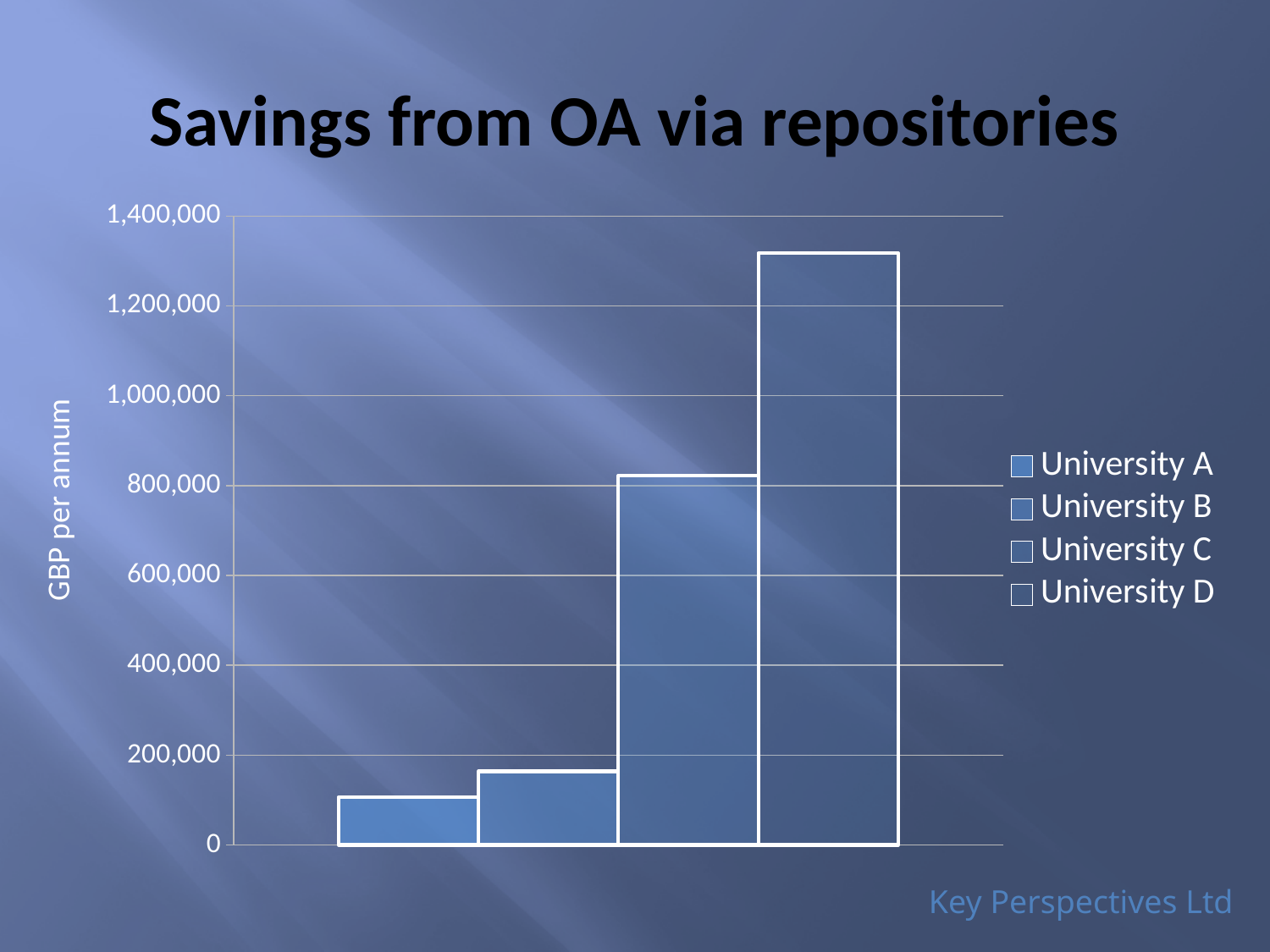
Do the bar values rise or fall from University A to University D? rise How many bars are plotted in the chart? 4 Is the value for University A greater or less than 200,000? less What is the label on the vertical axis? GBP per annum Is the value for University C greater or less than 600,000? greater Which university has the lowest savings? University A What kind of chart is shown on the slide? bar chart What is the title of the chart? Savings from OA via repositories Is the value for University D greater or less than 1,200,000? greater How many entries does the legend list? 4 Which university has the highest savings? University D Which has larger savings, University B or University C? University C